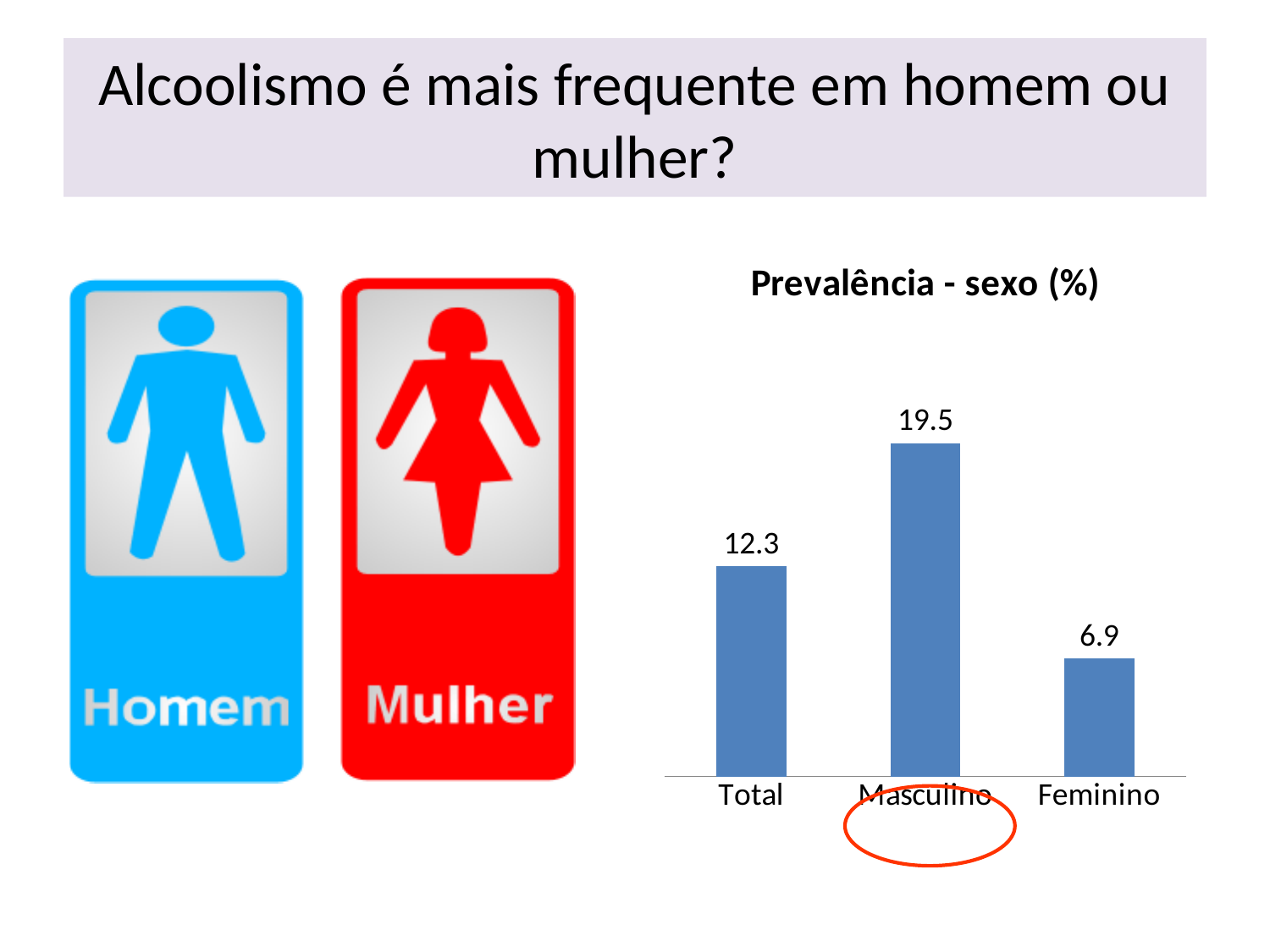
What kind of chart is shown on the slide? Bar chart Which category has the highest value in the chart? Masculino Which is larger, the value for Total or the value for Feminino? Total What is the value for Total in the chart? 12.3 Which category has the lowest value in the chart? Feminino What is the value for Masculino in the chart? 19.5 How many categories are shown in the chart? 3 Which is larger, the value for Masculino or the value for Feminino? Masculino What is the title of the chart? Prevalência - sexo (%) What is the value for Feminino in the chart? 6.9 What is the difference between the values for Masculino and Total? 7.2 What is the difference between the values for Masculino and Feminino? 12.6